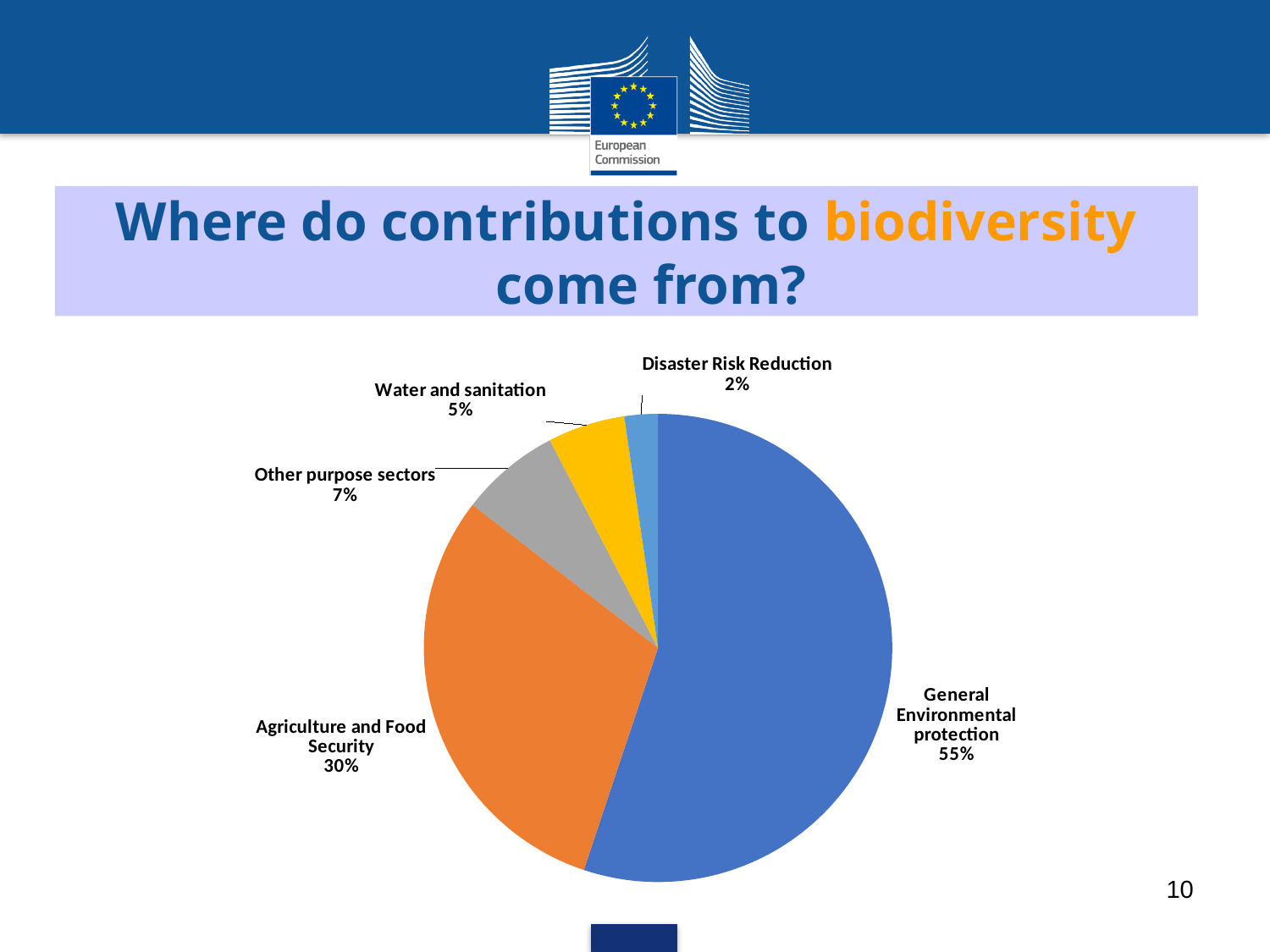
What share of contributions to biodiversity comes from Water and sanitation? 5% What share of contributions to biodiversity comes from Disaster Risk Reduction? 2% What share of contributions to biodiversity comes from Other purpose sectors? 7% Which is larger: the share for Other purpose sectors or the share for Water and sanitation? Other purpose sectors Which sector has the smallest share of contributions to biodiversity? Disaster Risk Reduction How many slices does the pie chart have? 5 What kind of chart is shown on the slide? pie chart Which sector has the largest share of contributions to biodiversity? General Environmental protection What share of contributions to biodiversity comes from Agriculture and Food Security? 30% What colour is the slice for Agriculture and Food Security? orange What is the difference in percentage points between General Environmental protection and Agriculture and Food Security? 25 percentage points What share of contributions to biodiversity comes from General Environmental protection? 55%